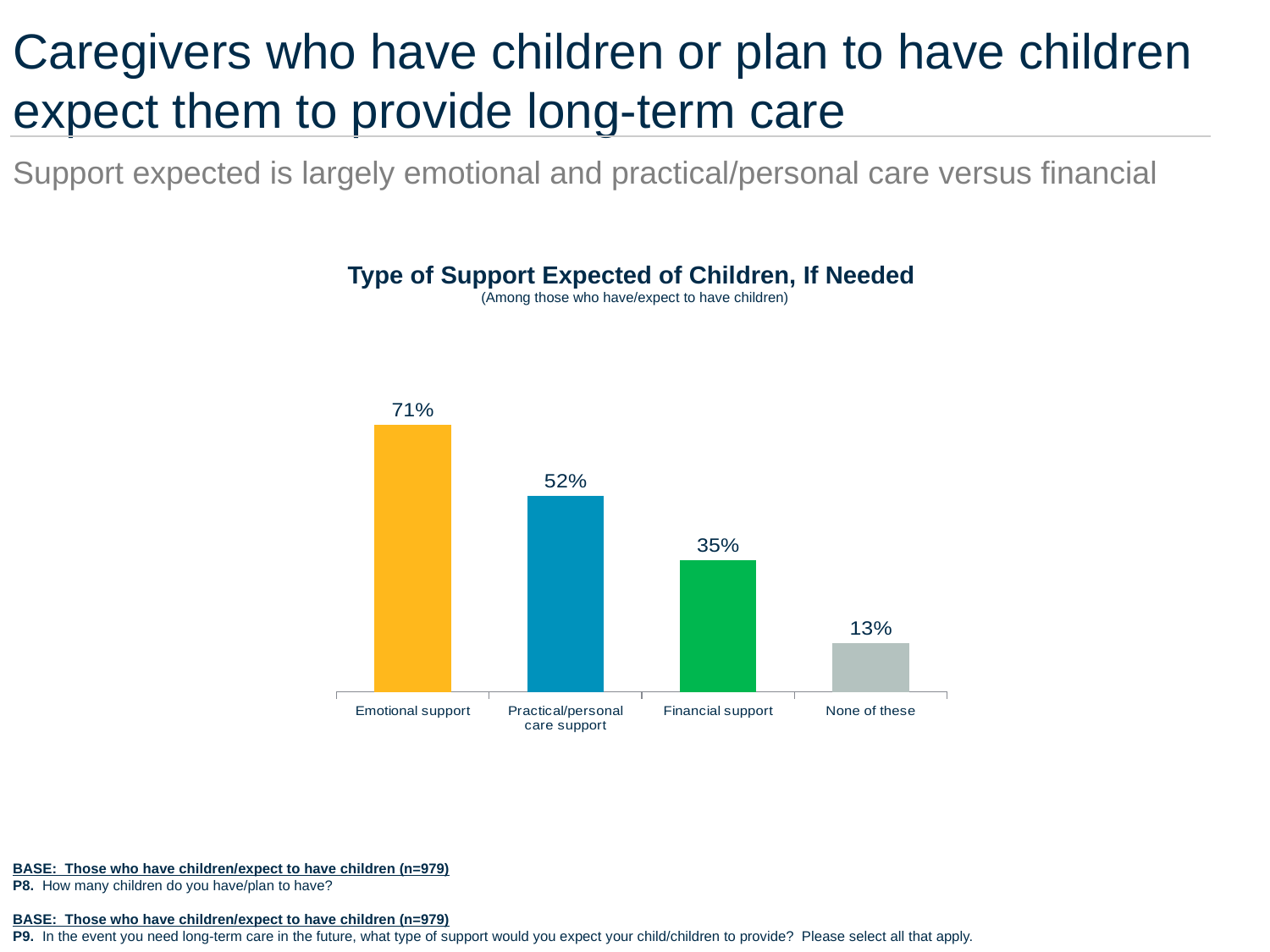
What is the difference between Emotional support and Financial support? 36% Which category has the lowest value? None of these What is the value for Financial support? 35% What is the value for Practical/personal care support? 52% What percentage of respondents expect emotional support from their children? 71% How many categories are shown in the chart? 4 What kind of chart is shown on the slide? Bar chart Which type of support has the highest value? Emotional support What is the difference between Practical/personal care support and None of these? 39% What is the title of the chart? Type of Support Expected of Children, If Needed Which is larger, Practical/personal care support or Financial support? Practical/personal care support What percentage selected None of these? 13%